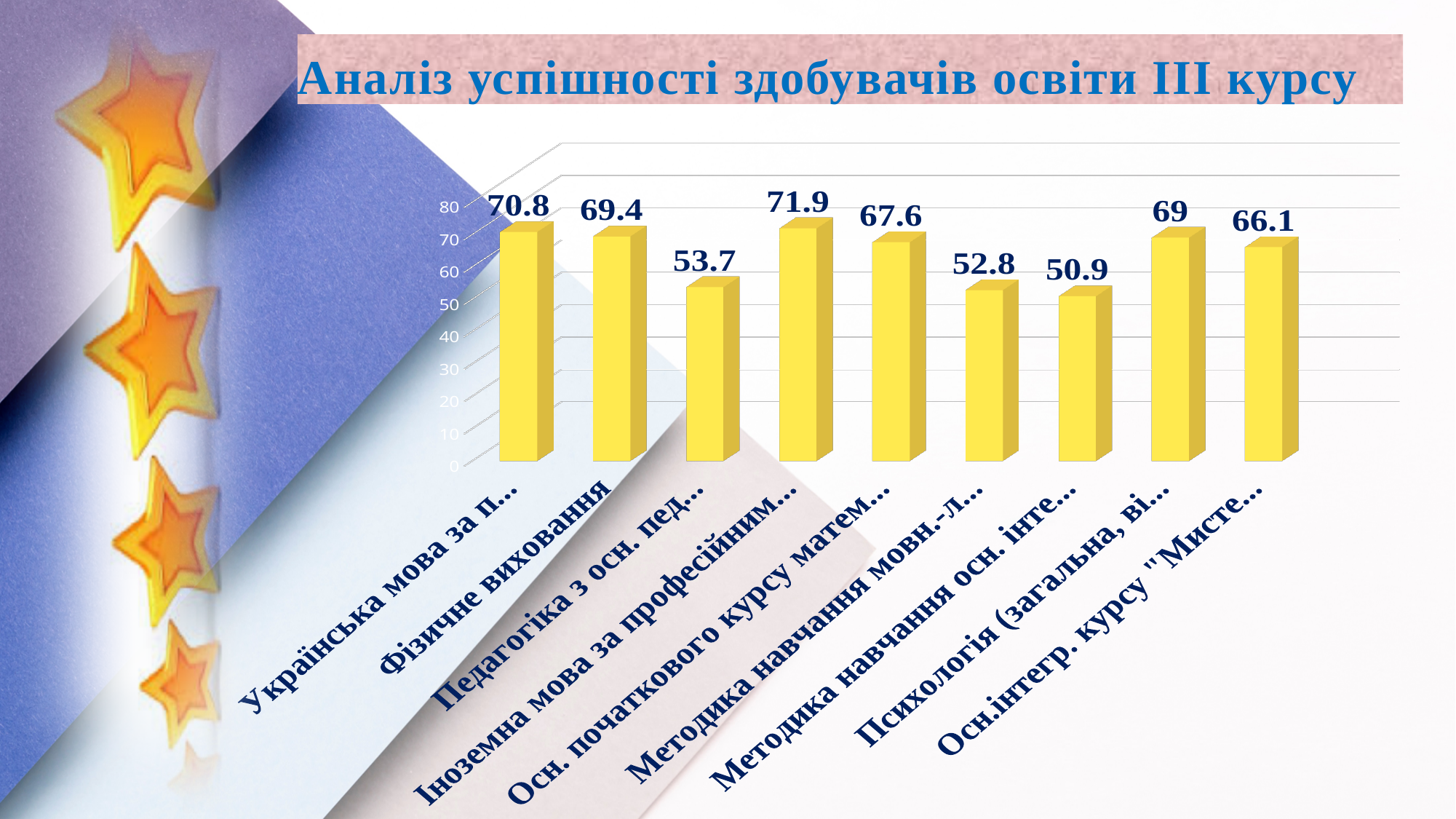
Which is larger: the value for "Педагогіка з осн. пед..." or the value for "Методика навчання мовн.-л..."? Педагогіка з осн. пед... What kind of chart is shown on the slide? bar chart What is the value for the bar labelled "Осн.інтегр. курсу "Мисте..."? 66.1 Is the value for "Осн. початкового курсу матем..." greater or less than 60? greater Which category has the lowest value? Методика навчання осн. інте... What is the title of the slide? Аналіз успішності здобувачів освіти ІІІ курсу What is the value for the bar labelled "Іноземна мова за професійним..."? 71.9 What is the value for the bar labelled "Психологія (загальна, ві..."? 69 How many bars does the chart show? 9 Which category has the highest value? Іноземна мова за професійним... What is the value for Фізичне виховання? 69.4 What is the difference between the values for "Українська мова за п..." and "Фізичне виховання"? 1.4